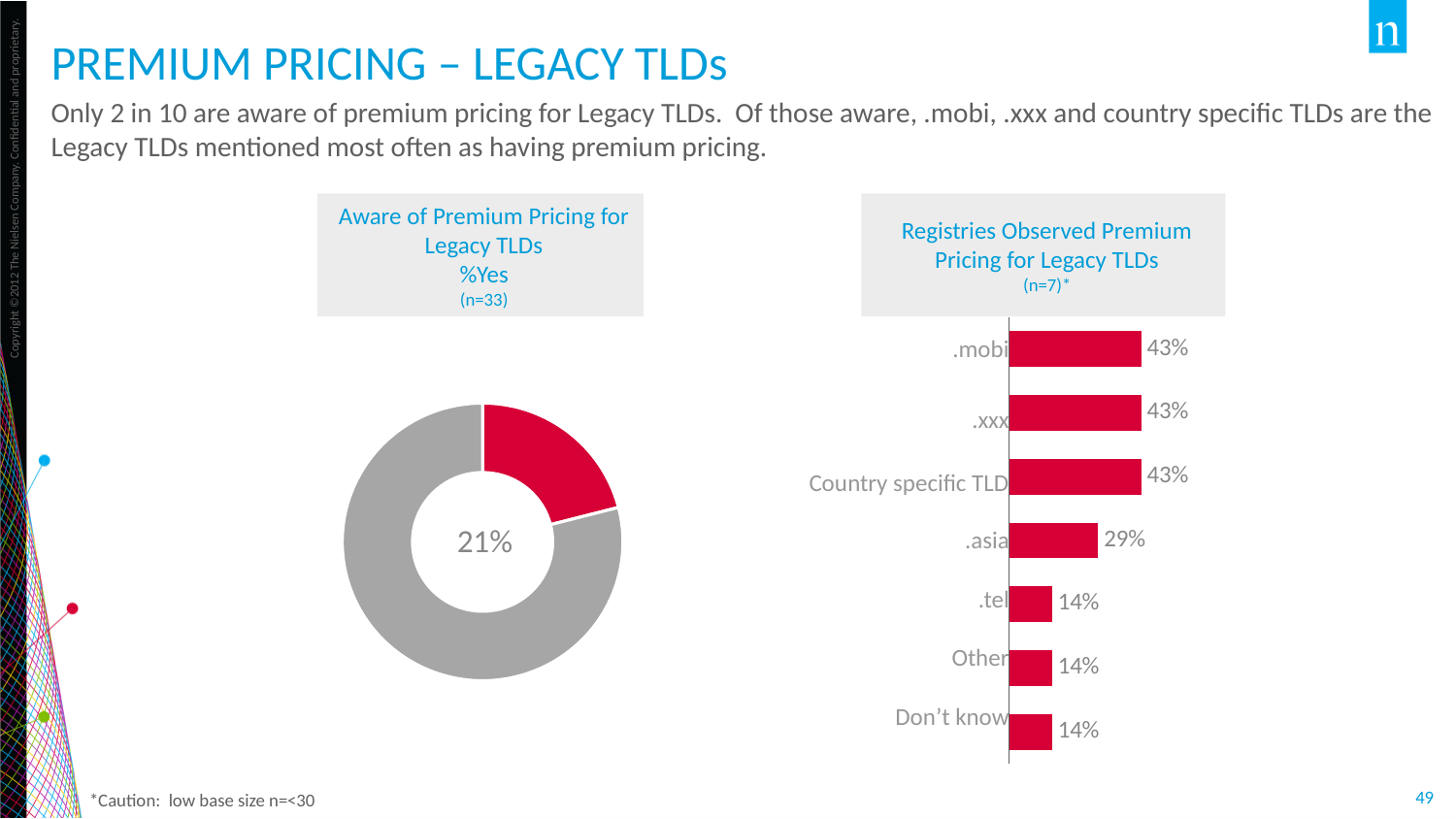
In the 'Registries Observed Premium Pricing for Legacy TLDs' chart, what is the value for .tel? 14% In the 'Registries Observed Premium Pricing for Legacy TLDs' chart, what is the value for .mobi? 43% What kind of chart is the 'Aware of Premium Pricing for Legacy TLDs' chart? Donut chart In the 'Registries Observed Premium Pricing for Legacy TLDs' chart, what is the value for .asia? 29% In the 'Registries Observed Premium Pricing for Legacy TLDs' chart, which has the larger value, .asia or .tel? .asia In the 'Registries Observed Premium Pricing for Legacy TLDs' chart, what is the highest value shown? 43% How many categories are shown in the 'Registries Observed Premium Pricing for Legacy TLDs' chart? 7 In the 'Registries Observed Premium Pricing for Legacy TLDs' chart, what is the value for Country specific TLD? 43% In the 'Registries Observed Premium Pricing for Legacy TLDs' chart, what is the difference between the values for .mobi and .asia? 14% In the 'Aware of Premium Pricing for Legacy TLDs' chart, what percentage answered Yes? 21% What kind of chart is the 'Registries Observed Premium Pricing for Legacy TLDs' chart? Bar chart In the 'Registries Observed Premium Pricing for Legacy TLDs' chart, what is the lowest value shown? 14%